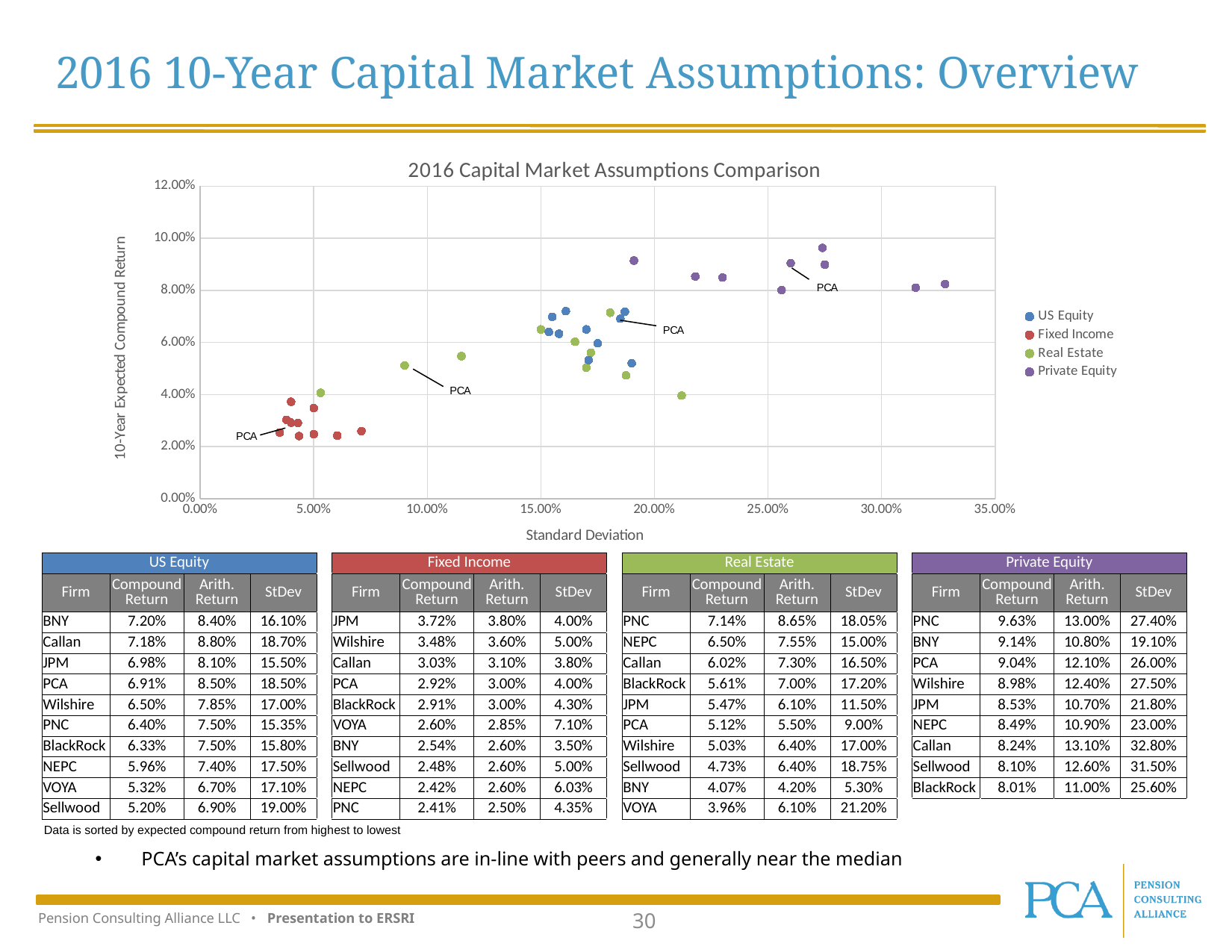
What is the label of the chart's horizontal axis? Standard Deviation Is the PCA point in the Private Equity series greater or less than 8.00% on the expected compound return axis? greater Is the PCA point in the Fixed Income series greater or less than 4.00% on the expected compound return axis? less What kind of chart is shown on the slide? Scatter chart What is the title of the chart? 2016 Capital Market Assumptions Comparison Which series in the chart has the lowest expected compound returns? Fixed Income Is the PCA point in the Real Estate series greater or less than 6.00% on the expected compound return axis? less Which series in the chart has the highest standard deviations? Private Equity Across the chart, do expected compound returns generally rise or fall as standard deviation increases? rise How many series does the chart legend list? 4 Which has the higher expected compound return in the chart: the PCA Private Equity point or the PCA US Equity point? PCA Private Equity